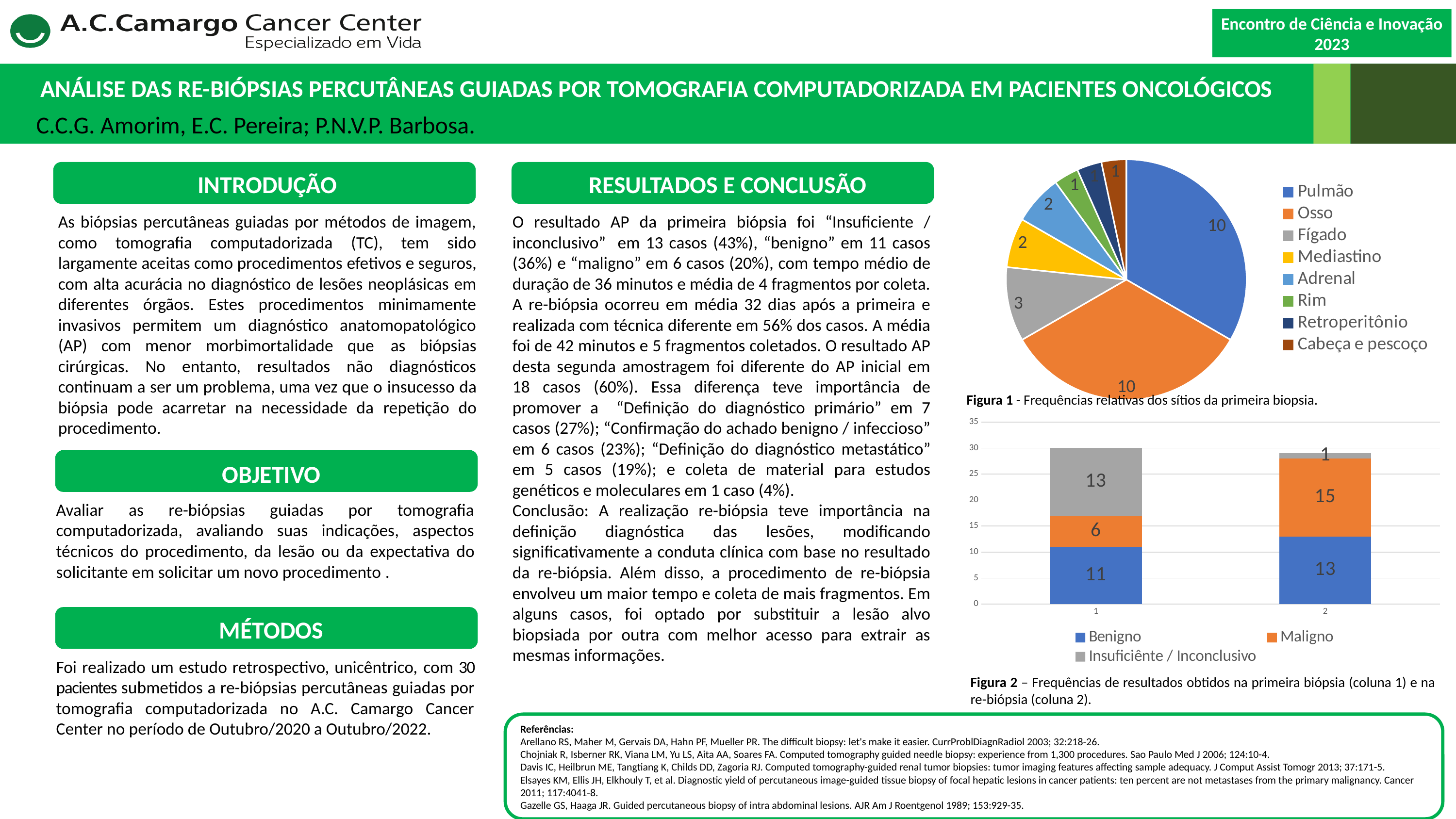
In the pie chart (Figura 1), what is the value for Fígado? 3 In the pie chart (Figura 1), what is the value for Osso? 10 In the pie chart (Figura 1), what is the difference between the values for Pulmão and Fígado? 7 In the pie chart (Figura 1), how many categories does the legend list? 8 In the stacked bar chart (Figura 2), what is the value for Insuficiênte / Inconclusivo in column 1? 13 In the stacked bar chart (Figura 2), how many series does the legend list? 3 In the pie chart (Figura 1), what share of the total does Fígado represent? 10% In the pie chart (Figura 1), which is larger, the value for Fígado or the value for Mediastino? Fígado In the stacked bar chart (Figura 2), what is the difference between the Maligno values in column 2 and column 1? 9 What kind of chart is Figura 2? Stacked bar chart In the stacked bar chart (Figura 2), what is the value for Maligno in column 2? 15 In the stacked bar chart (Figura 2), what is the total of the stacked bar for column 1? 30